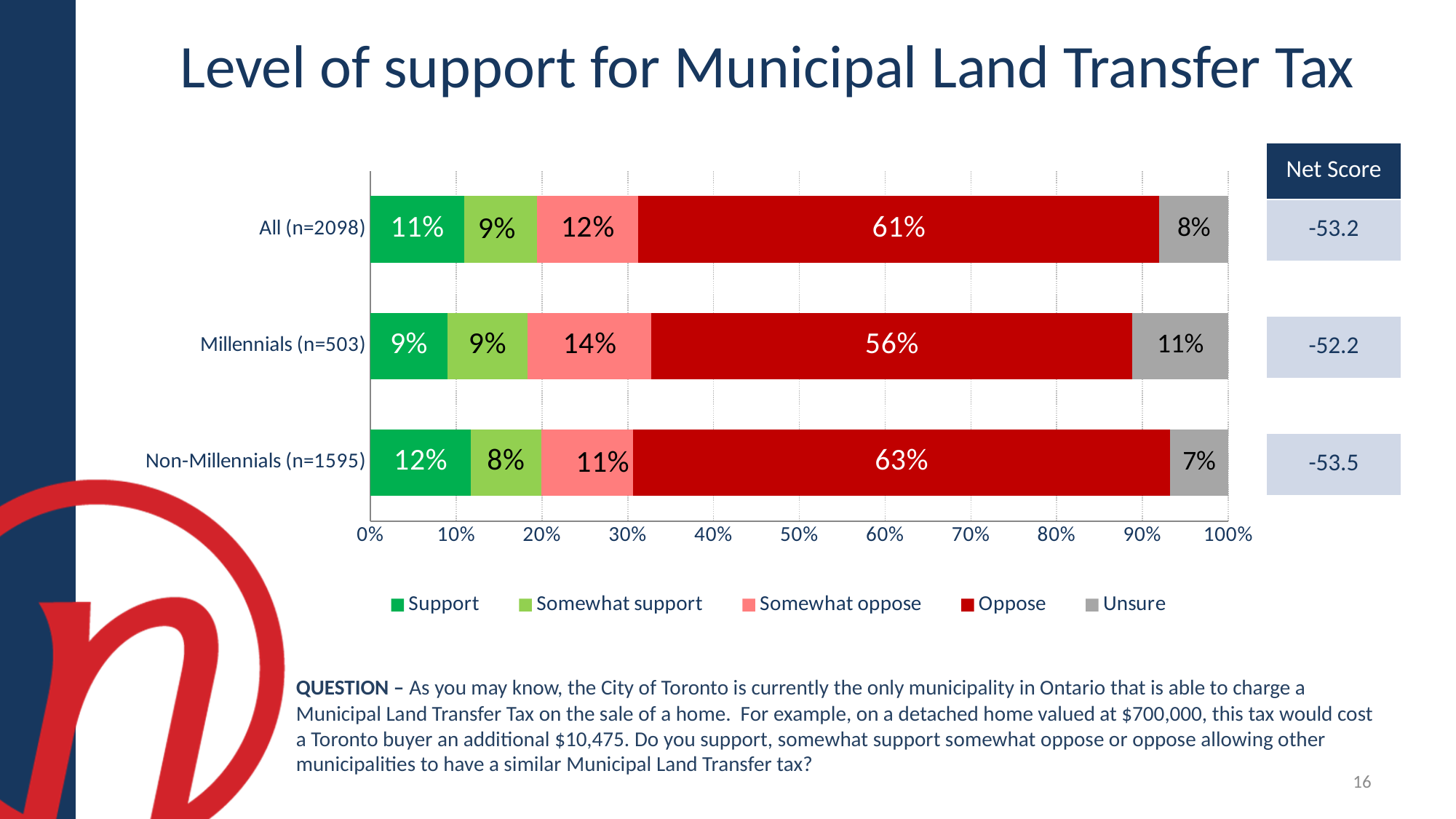
What percentage of Non-Millennials (n=1595) support the tax? 12% What percentage of All respondents (n=2098) oppose the Municipal Land Transfer Tax? 61% How many series does the legend list? 5 What kind of chart is shown on the slide? Stacked bar chart Which is larger: the Somewhat oppose percentage for Millennials (n=503) or for All (n=2098)? Millennials (n=503) What is the Net Score for Millennials (n=503)? -52.2 What percentage of Millennials (n=503) are unsure? 11% What is the combined Support and Somewhat support percentage for All (n=2098)? 20% Which group has the lowest Support percentage? Millennials (n=503) Which group has the highest Oppose percentage? Non-Millennials (n=1595) What is the difference between the Oppose percentage for Non-Millennials (n=1595) and Millennials (n=503)? 7% How many groups are shown on the chart? 3